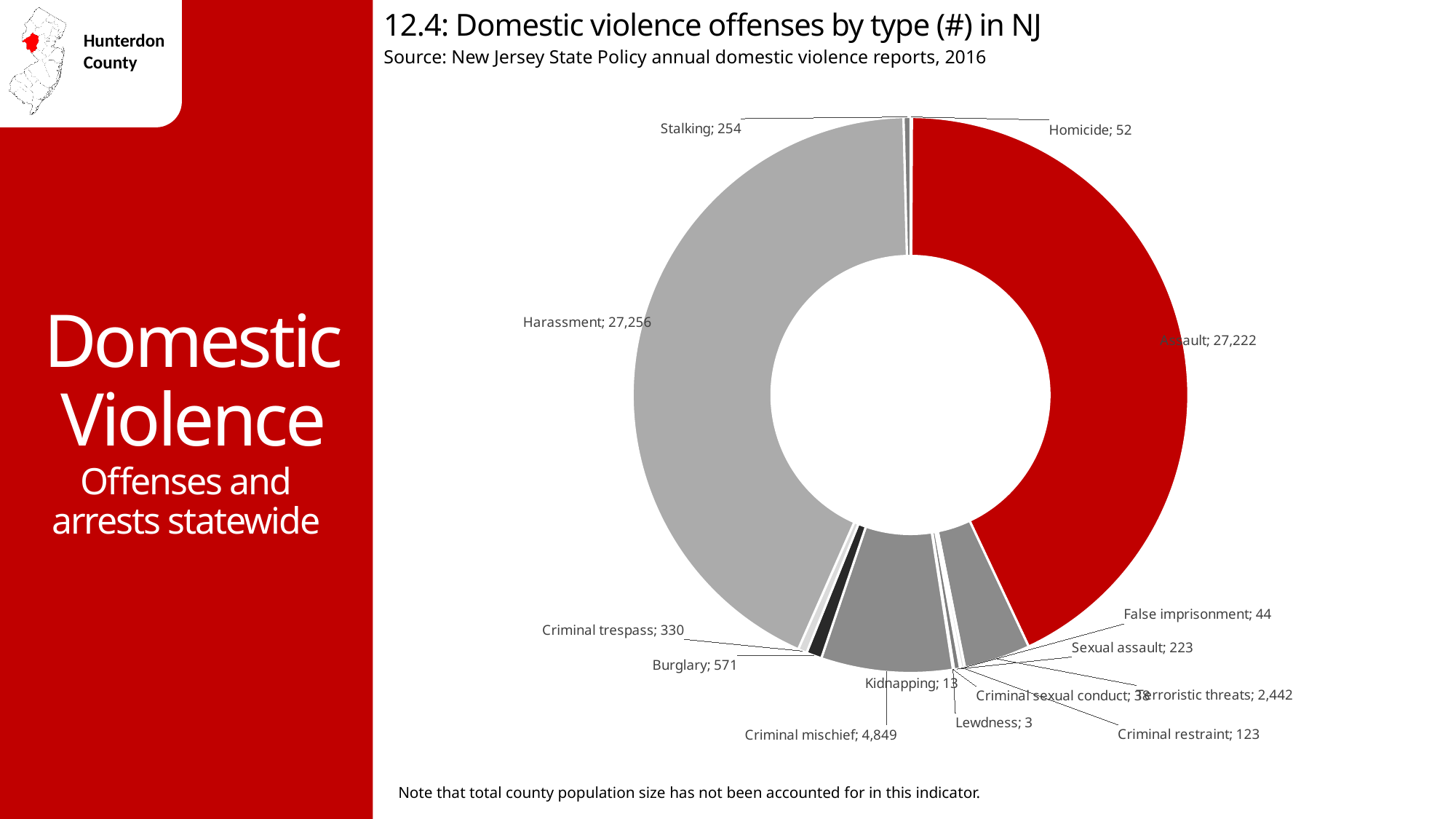
Which offense type has the smallest value on the chart? Lewdness What is the difference between the values for Criminal mischief and Terroristic threats? 2,407 How many domestic violence offenses of type Harassment are shown on the chart? 27,256 What is the value shown for Criminal mischief? 4,849 What is the value shown for Terroristic threats? 2,442 What colour is the Assault segment of the chart? Red What is the difference between the values for Burglary and Criminal trespass? 241 What is the value shown for Homicide? 52 Which is larger, the value for Harassment or the value for Assault? Harassment How many offense types are shown on the chart? 14 What kind of chart is shown on the slide? Doughnut chart What is the value shown for Assault? 27,222